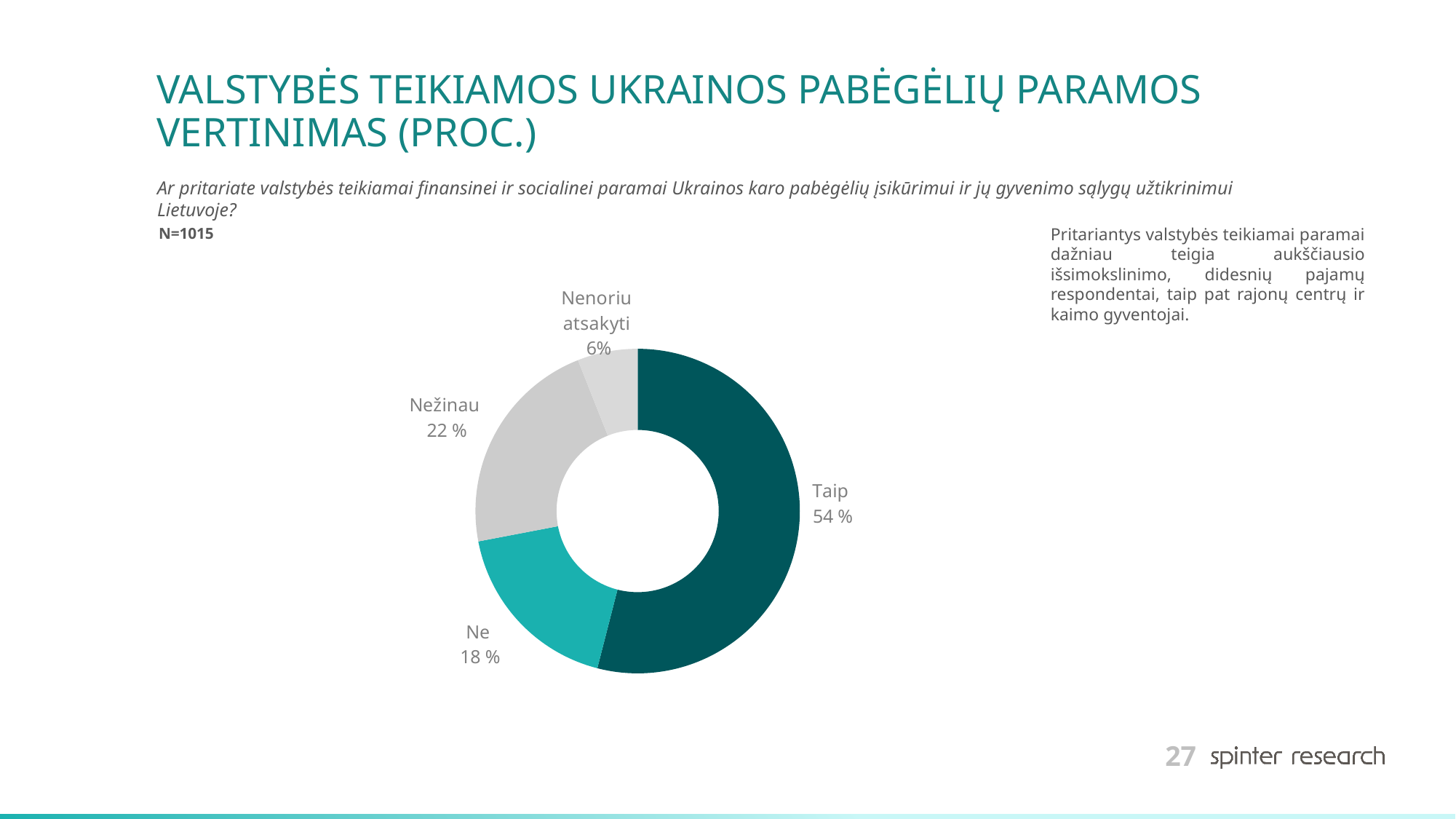
What is the sample size (N) stated on the slide? N=1015 Which is larger, the share for "Nežinau" or the share for "Ne"? Nežinau What percentage of respondents answered "Ne"? 18 % How many answer categories are shown in the chart? 4 What is the difference in percentage points between "Nežinau" and "Ne"? 4 What percentage of respondents answered "Taip"? 54 % What kind of chart is shown on the slide? Donut (pie) chart Which answer category has the largest share of the chart? Taip What is the difference in percentage points between "Taip" and "Ne"? 36 What percentage of respondents answered "Nežinau"? 22 % What percentage of respondents answered "Nenoriu atsakyti"? 6% Which answer category has the smallest share of the chart? Nenoriu atsakyti